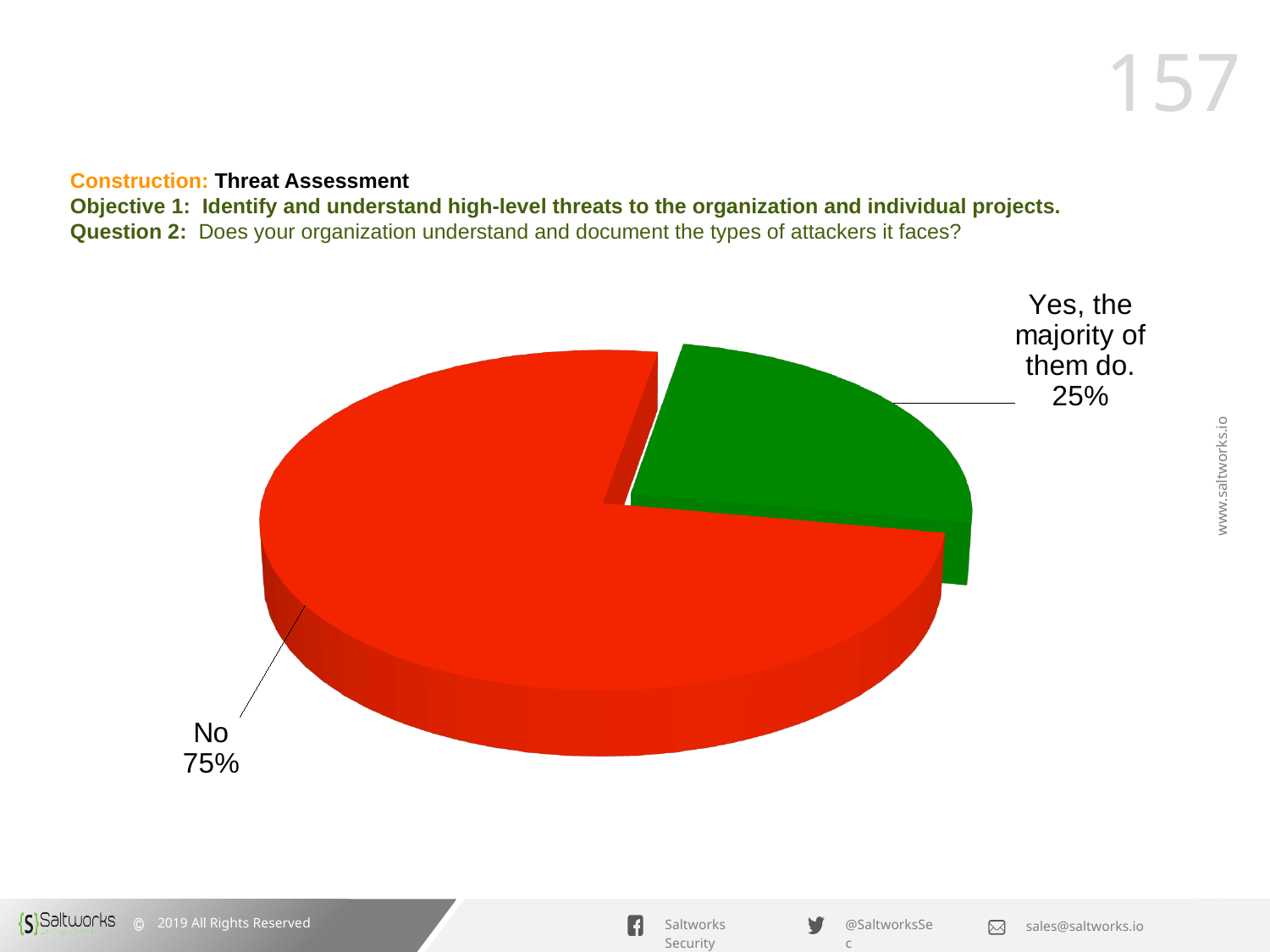
What colour is the "No" slice of the pie? red How many slices does the pie chart have? 2 What kind of chart is shown on the slide? pie chart What is the difference in percentage points between the "No" slice and the "Yes, the majority of them do." slice? 50 What percentage of the pie is labelled "Yes, the majority of them do."? 25% What percentage of the pie is labelled "No"? 75% What colour is the "Yes, the majority of them do." slice of the pie? green What share of the pie does the "No" slice represent? 75% Which slice of the pie is the smallest? Yes, the majority of them do. Which slice of the pie is the largest? No Which is larger: the "No" slice or the "Yes, the majority of them do." slice? No